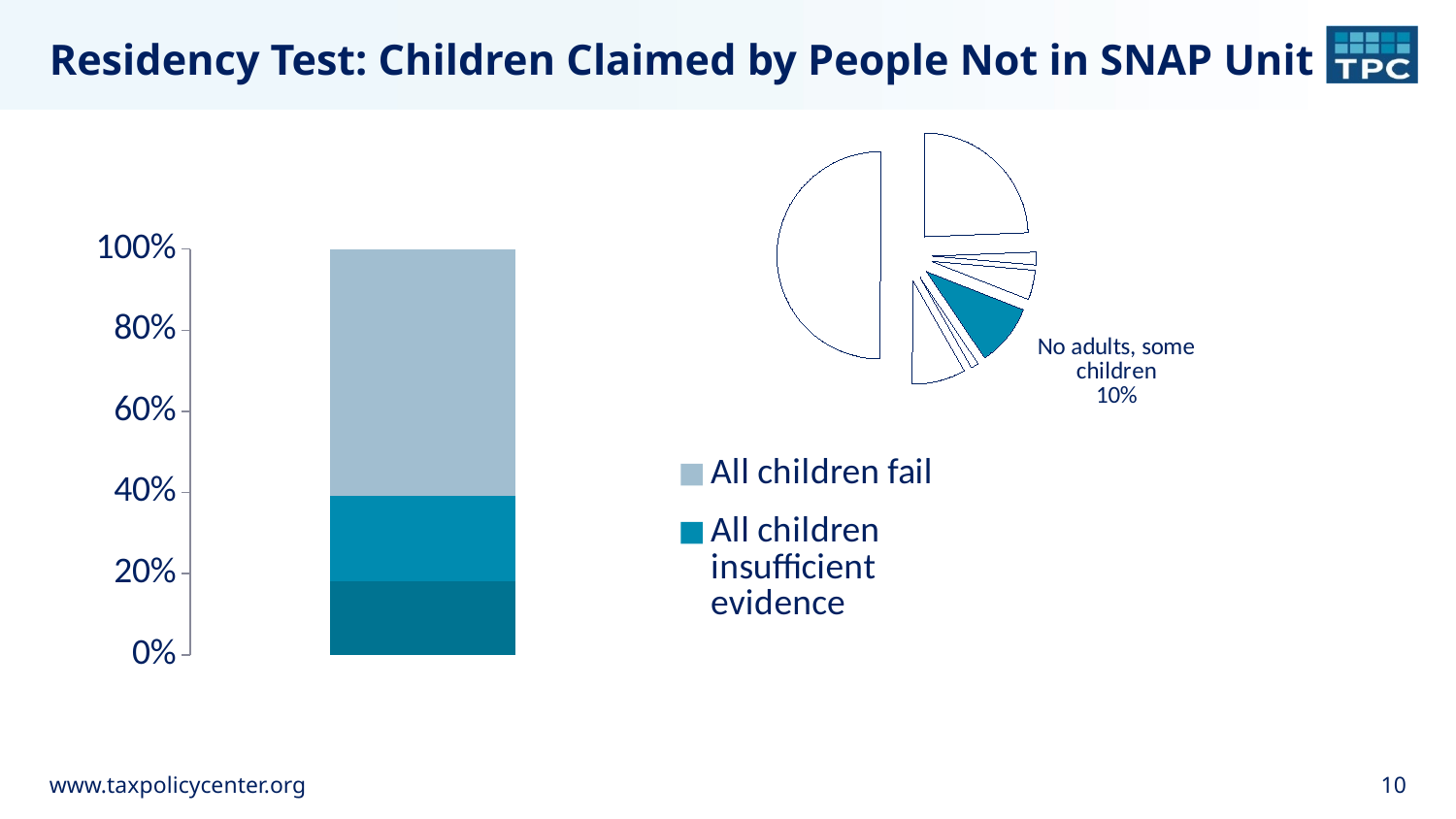
In the bar chart, which segment is larger: 'All children fail' or 'All children insufficient evidence'? All children fail How many entries does the legend list? 2 What kind of chart is on the left side of the slide? bar chart In the bar chart, is the share for 'All children insufficient evidence' greater or less than 40%? less Which legend entry is shown in light blue? All children fail In the bar chart, is the share for 'All children fail' greater or less than 50%? greater What is the highest value shown on the bar chart's vertical axis? 100% In the bar chart, which legend category has the largest segment? All children fail How many bars does the bar chart show? 1 What kind of chart is on the right side of the slide? pie chart In the pie chart, what percentage is shown for the 'No adults, some children' slice? 10%